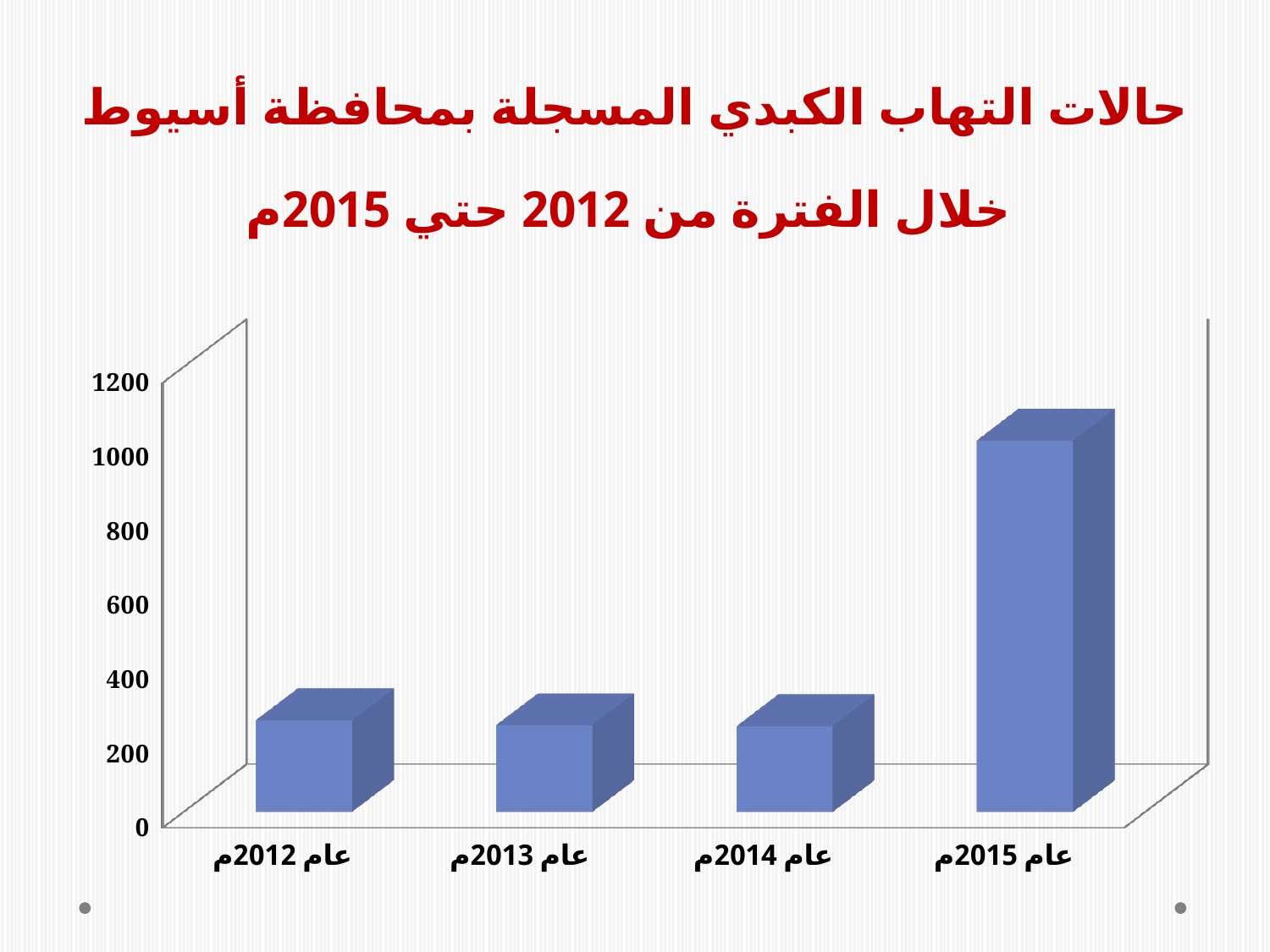
What is the highest tick value shown on the vertical axis of the chart? 1200 What period does the slide title say the chart covers? من 2012 حتي 2015م How many categories (years) are shown on the x axis of the chart? 4 Which is larger, the value for عام 2014م or the value for عام 2015م? عام 2015م Is the value for عام 2013م greater or less than 600? less Is the value for عام 2014م greater or less than 400? less Does the value rise or fall from عام 2014م to عام 2015م? rise Is the value for عام 2012م greater or less than 400? less What kind of chart is shown on the slide? bar chart Which is larger, the value for عام 2015م or the value for عام 2012م? عام 2015م Which year has the highest value in the chart? عام 2015م